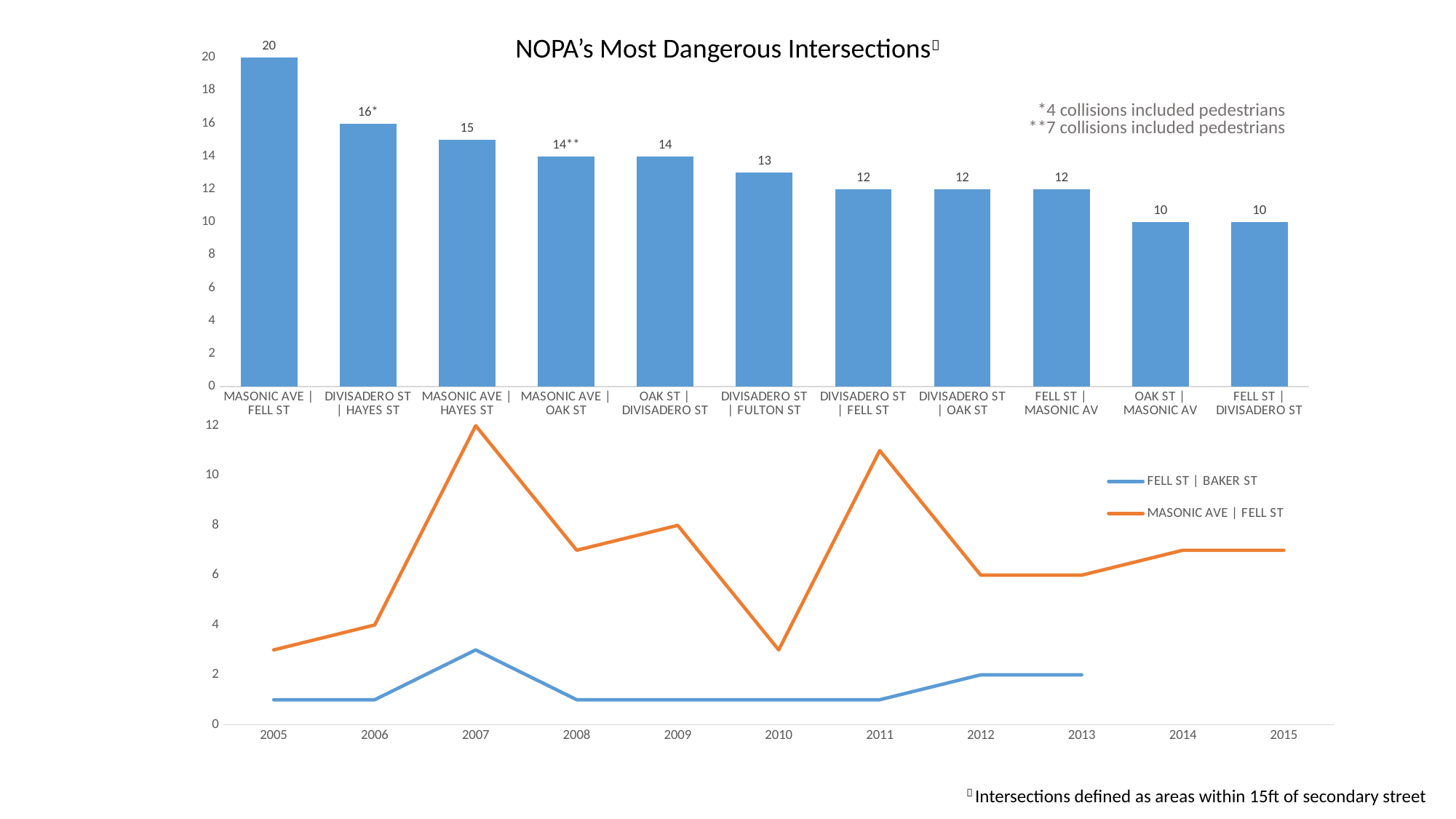
In the bar chart titled NOPA's Most Dangerous Intersections, do the values rise or fall from left to right? fall In the bottom line chart, is the value for MASONIC AVE | FELL ST in 2010 greater or less than 4? less In the bar chart titled NOPA's Most Dangerous Intersections, what is the value for MASONIC AVE | FELL ST? 20 In the bottom line chart, which series is drawn in orange? MASONIC AVE | FELL ST In the bar chart titled NOPA's Most Dangerous Intersections, what is the value for DIVISADERO ST | FULTON ST? 13 How many series does the legend of the bottom line chart list? 2 In the bar chart titled NOPA's Most Dangerous Intersections, what is the difference between the values for MASONIC AVE | FELL ST and MASONIC AVE | HAYES ST? 5 How many intersections are shown in the bar chart titled NOPA's Most Dangerous Intersections? 11 In the bottom line chart, what is the value for MASONIC AVE | FELL ST in 2007? 12 In the bar chart titled NOPA's Most Dangerous Intersections, which is larger: the value for DIVISADERO ST | HAYES ST or the value for OAK ST | DIVISADERO ST? DIVISADERO ST | HAYES ST In the bar chart titled NOPA's Most Dangerous Intersections, which intersection has the highest value? MASONIC AVE | FELL ST What kind of chart is the top chart on the slide? bar chart